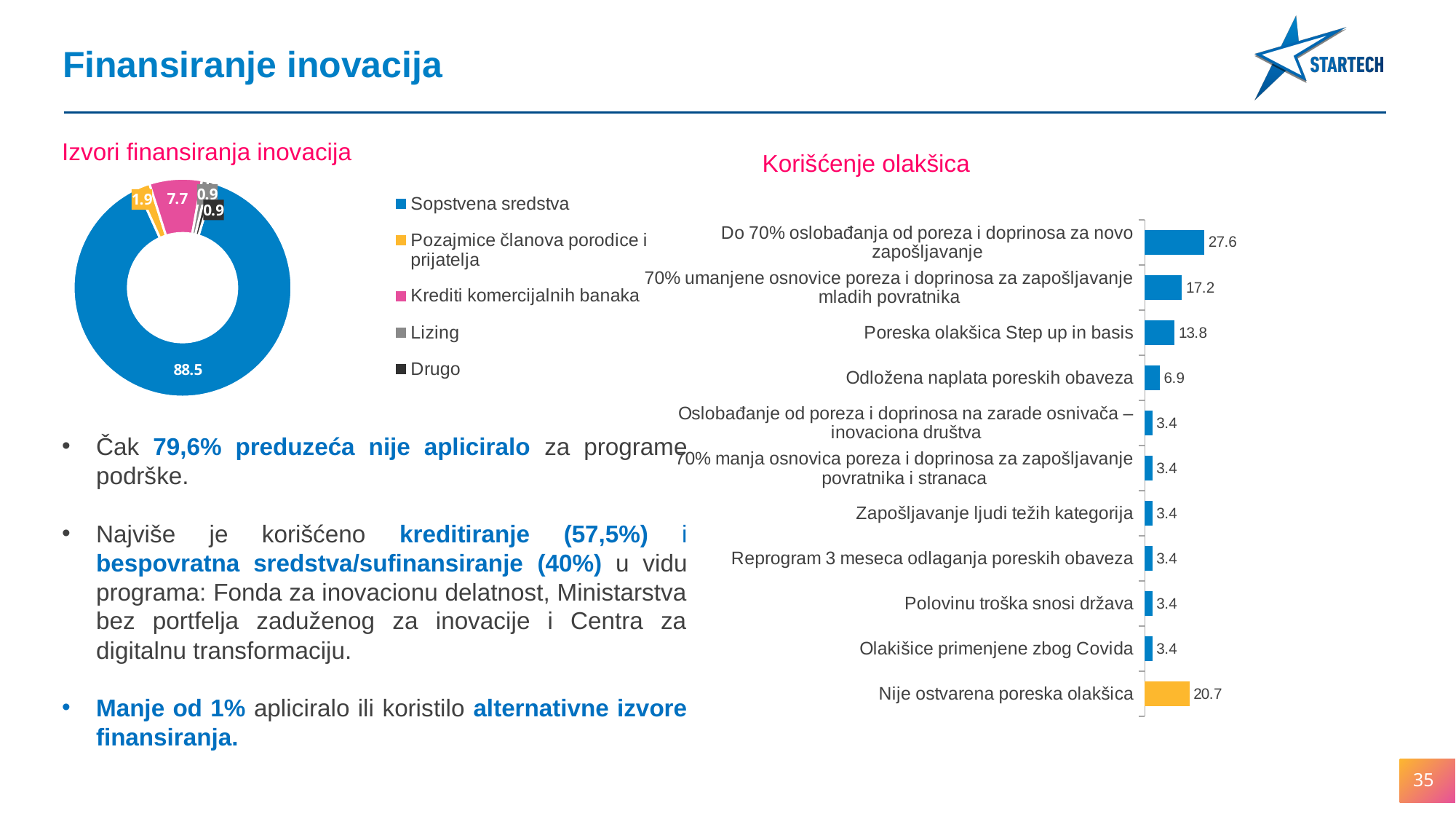
In the 'Izvori finansiranja inovacija' chart, how many entries does the legend list? 5 In the 'Izvori finansiranja inovacija' chart, what is the value for Sopstvena sredstva? 88.5 In the 'Izvori finansiranja inovacija' chart, which category has the largest share? Sopstvena sredstva In the 'Korišćenje olakšica' chart, what is the difference between 'Do 70% oslobađanja od poreza i doprinosa za novo zapošljavanje' and '70% umanjene osnovice poreza i doprinosa za zapošljavanje mladih povratnika'? 10.4 In the 'Korišćenje olakšica' chart, what is the value for 'Nije ostvarena poreska olakšica'? 20.7 What kind of chart is 'Izvori finansiranja inovacija'? Doughnut chart How many categories are shown in the 'Korišćenje olakšica' chart? 11 In the 'Izvori finansiranja inovacija' chart, what is the value for Krediti komercijalnih banaka? 7.7 What kind of chart is 'Korišćenje olakšica'? Bar chart In the 'Korišćenje olakšica' chart, what is the value for 'Poreska olakšica Step up in basis'? 13.8 In the 'Korišćenje olakšica' chart, which category has the highest value? Do 70% oslobađanja od poreza i doprinosa za novo zapošljavanje In the 'Korišćenje olakšica' chart, which is larger: 'Odložena naplata poreskih obaveza' or 'Nije ostvarena poreska olakšica'? Nije ostvarena poreska olakšica